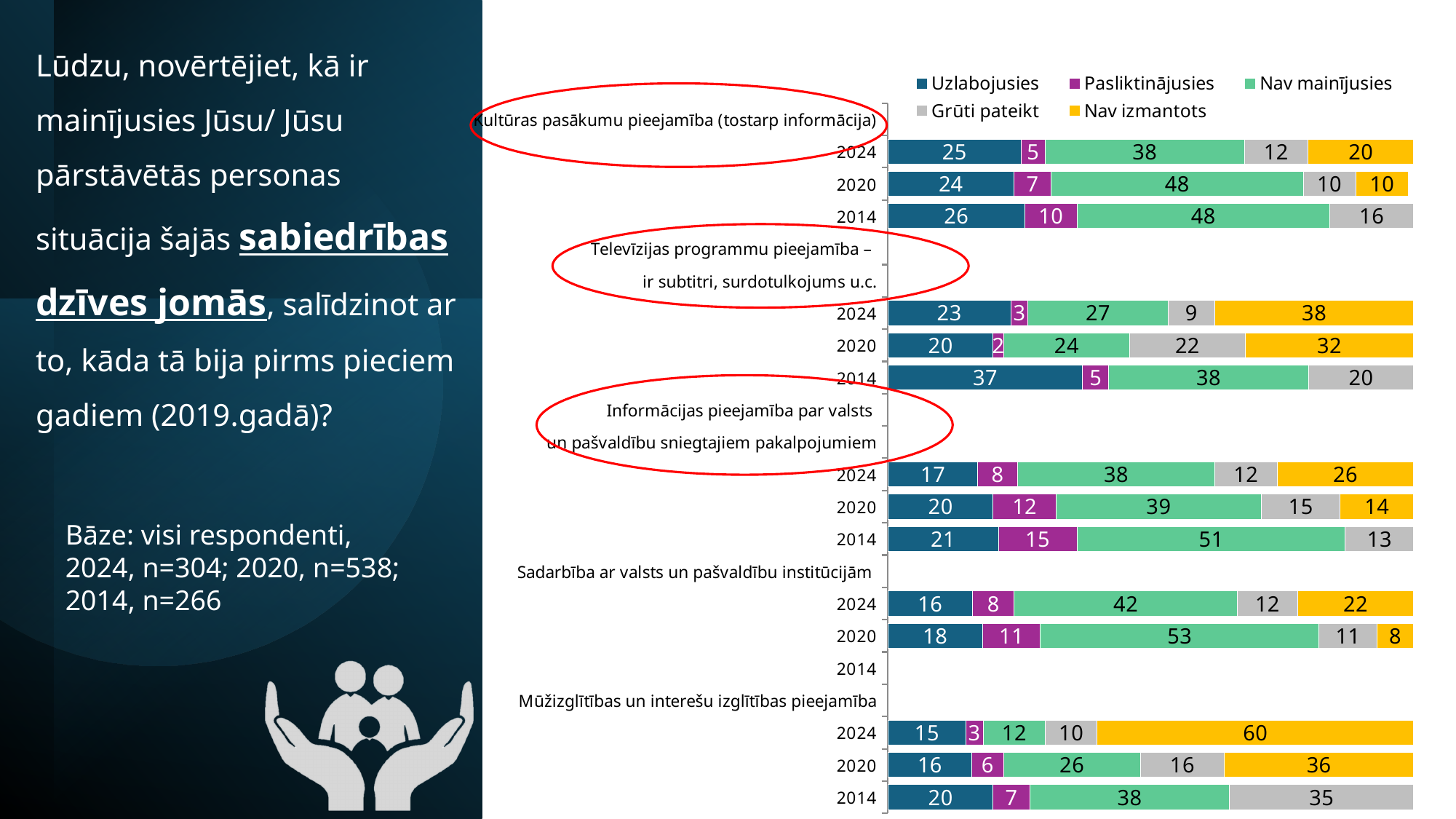
What is the 'Grūti pateikt' value for 'Televīzijas programmu pieejamība – ir subtitri, surdotulkojums u.c.' in 2020? 22 How many series does the legend list? 5 Which is larger for 'Kultūras pasākumu pieejamība (tostarp informācija)' in 2020: 'Nav mainījusies' or 'Uzlabojusies'? Nav mainījusies What is the 'Nav mainījusies' value for 'Sadarbība ar valsts un pašvaldību institūcijām' in 2020? 53 Which year has the lowest 'Pasliktinājusies' value for 'Informācijas pieejamība par valsts un pašvaldību sniegtajiem pakalpojumiem'? 2024 What is the difference between the 'Nav izmantots' values for 'Mūžizglītības un interešu izglītības pieejamība' in 2024 and 2020? 24 Which year has the highest 'Uzlabojusies' value for 'Televīzijas programmu pieejamība – ir subtitri, surdotulkojums u.c.'? 2014 What is the 'Uzlabojusies' value for 'Kultūras pasākumu pieejamība (tostarp informācija)' in 2024? 25 What is the total of the 2024 bar for 'Sadarbība ar valsts un pašvaldību institūcijām'? 100 What kind of chart is shown on the slide? stacked bar chart What is the 'Nav izmantots' value for 'Mūžizglītības un interešu izglītības pieejamība' in 2024? 60 Which colour represents 'Nav izmantots' in the chart? yellow